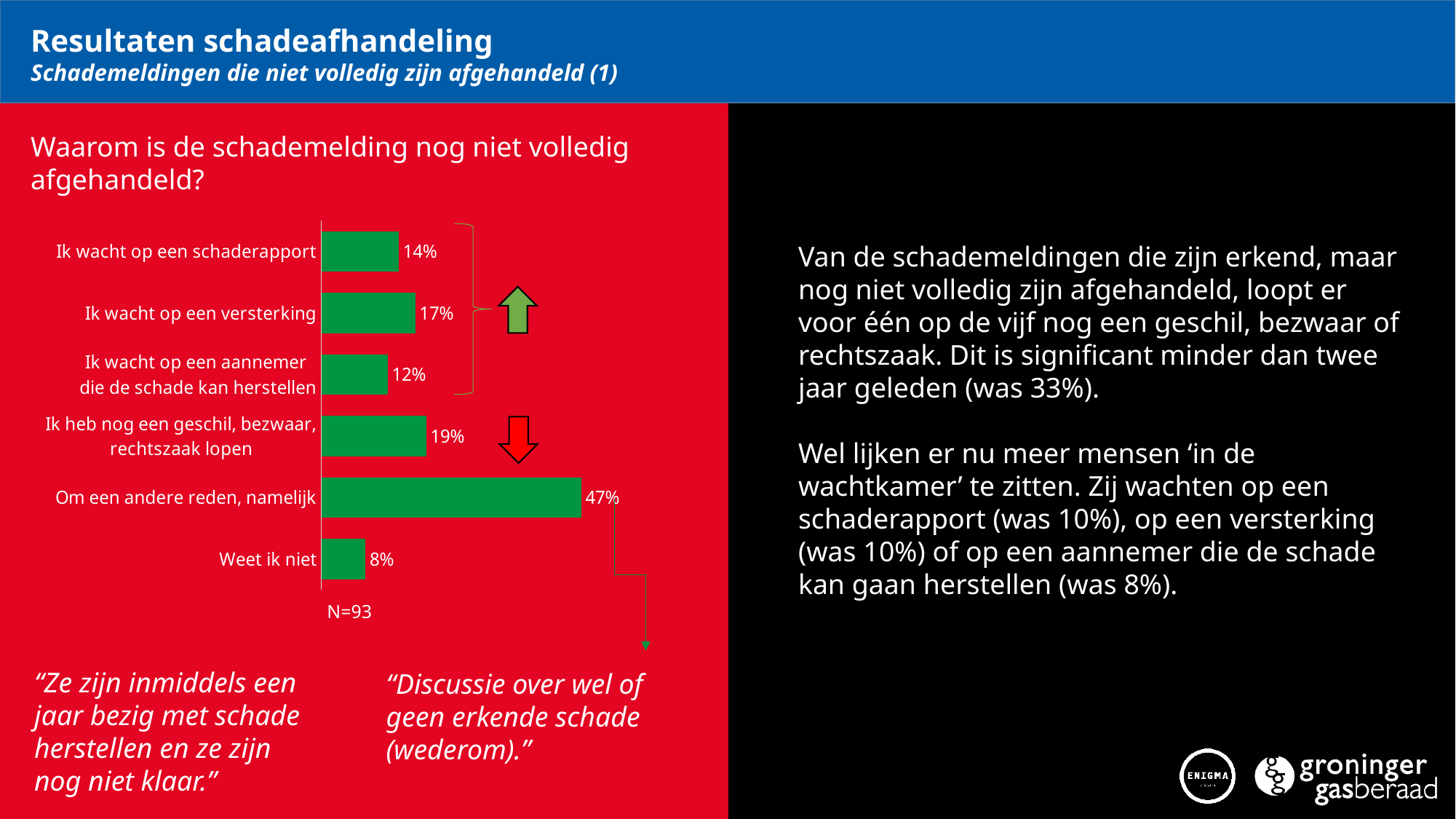
Which category has the lowest percentage? Weet ik niet What percentage is shown for 'Ik wacht op een schaderapport'? 14% What kind of chart is shown on the slide? Bar chart Which category has the highest percentage? Om een andere reden, namelijk What percentage is shown for 'Ik heb nog een geschil, bezwaar, rechtszaak lopen'? 19% What percentage is shown for 'Ik wacht op een versterking'? 17% What is the combined percentage of the three 'waiting' categories (schaderapport, versterking, aannemer)? 43% What is the sample size (N) shown below the chart? N=93 What is the difference between 'Om een andere reden, namelijk' and 'Ik heb nog een geschil, bezwaar, rechtszaak lopen'? 28% What percentage is shown for 'Weet ik niet'? 8% How many categories are shown in the chart? 6 Which is larger: 'Ik wacht op een versterking' or 'Ik wacht op een aannemer die de schade kan herstellen'? Ik wacht op een versterking